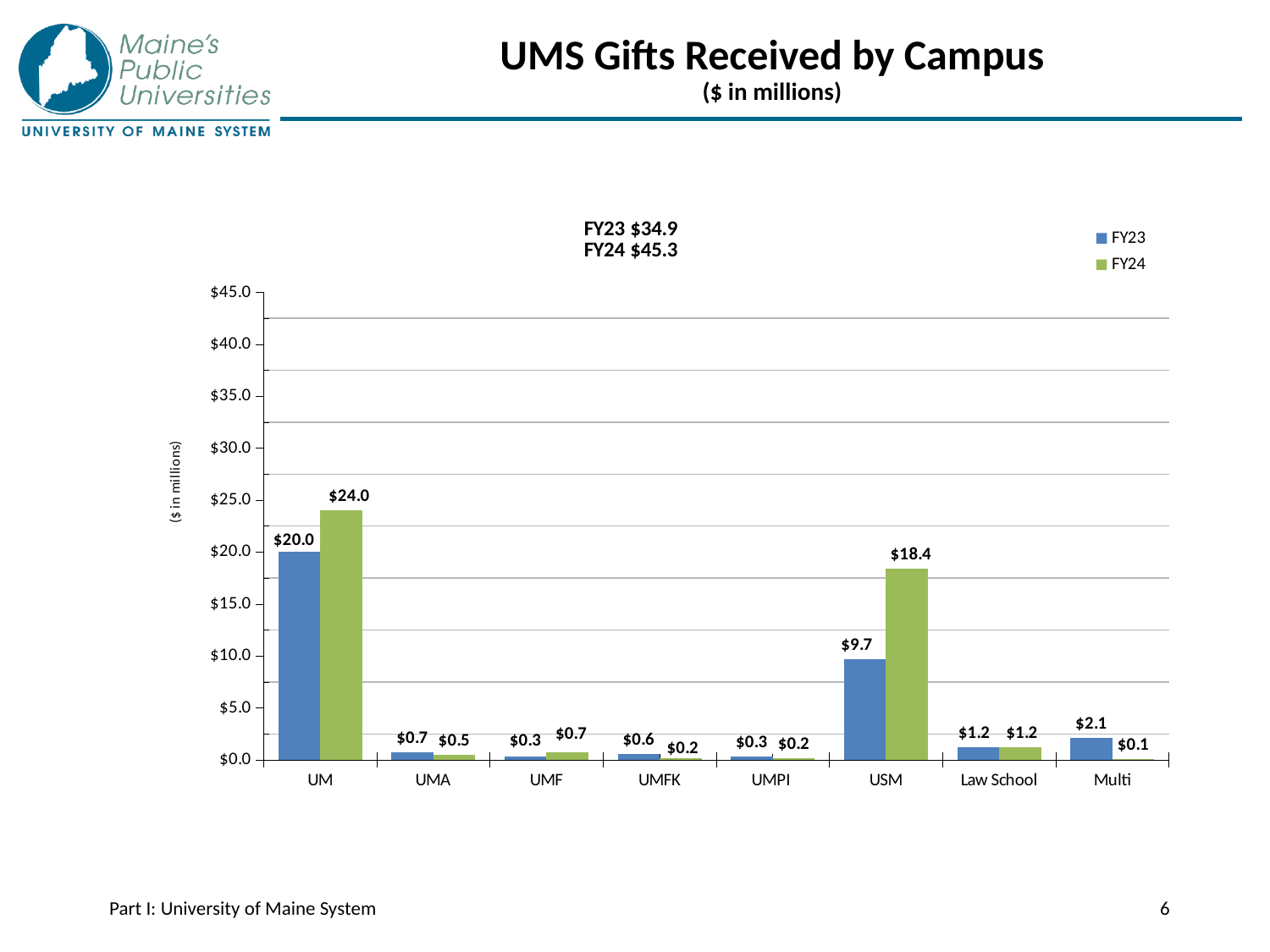
Is the FY24 value for USM greater or less than $15.0? greater What is the title of the chart? UMS Gifts Received by Campus What is the difference between the FY24 and FY23 values for USM? $8.7 What is the FY23 value for USM? $9.7 Which is larger for UMFK, the FY23 value or the FY24 value? FY23 What is the FY24 value for UM? $24.0 How many campus categories are shown on the x axis? 8 What is the FY24 value for Multi? $0.1 Which campus has the lowest FY24 value? Multi What kind of chart is shown on the slide? bar chart How many series does the legend list? 2 Which campus has the highest FY24 value? UM